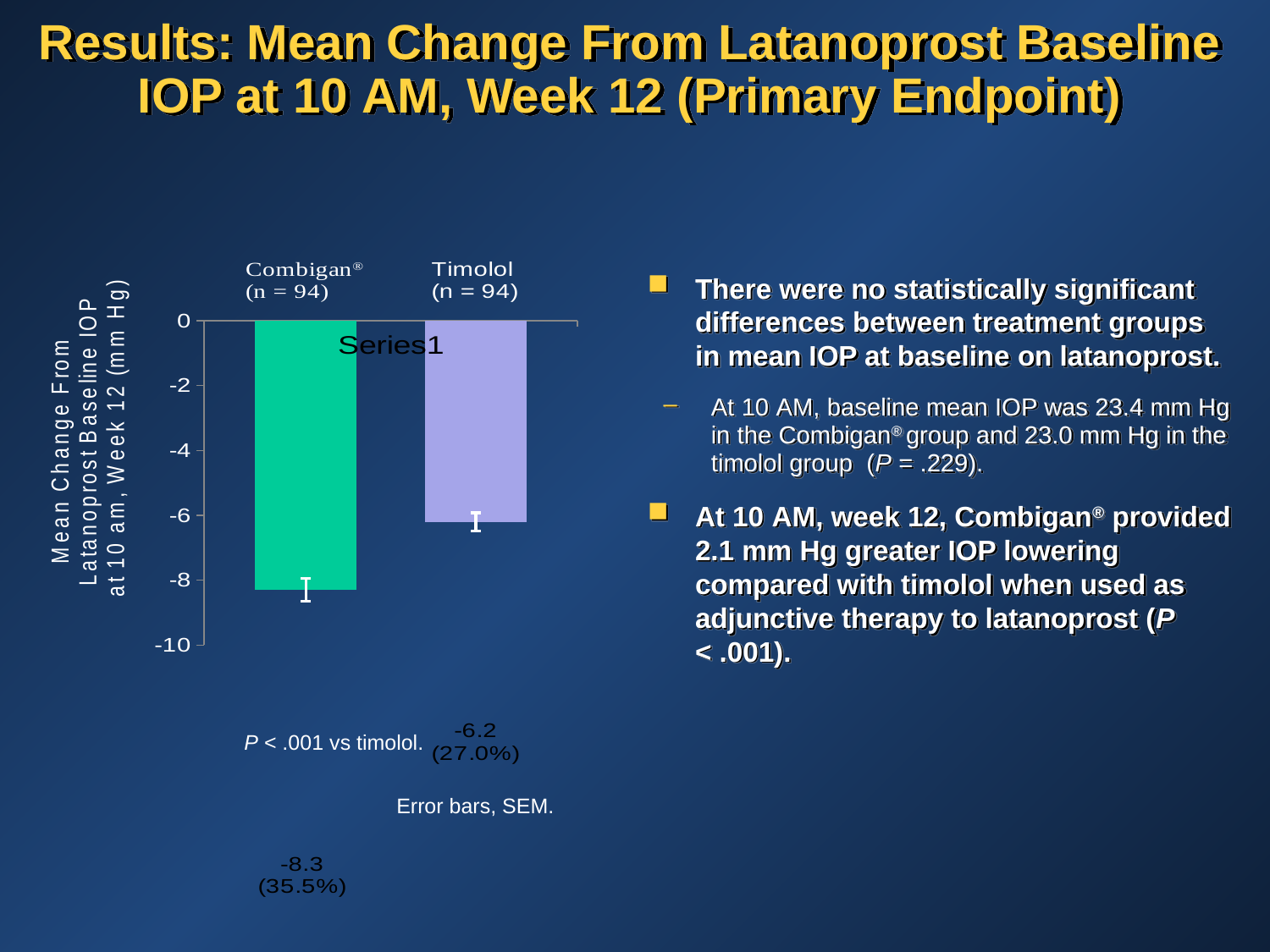
What do the error bars in the chart represent? SEM Is the value for the Timolol group greater or less than -4? less What percentage reduction is shown for the Combigan group? 35.5% How many bars are plotted in the chart? 2 What is the mean change from latanoprost baseline IOP for the Timolol group? -6.2 What percentage reduction is shown for the Timolol group? 27.0% What kind of chart is shown on the slide? bar chart Which group shows the larger reduction in IOP, Combigan or Timolol? Combigan What is the difference between the Combigan and Timolol mean IOP changes? 2.1 What is the mean change from latanoprost baseline IOP for the Combigan group? -8.3 How many patients (n) are in each treatment group shown in the chart? 94